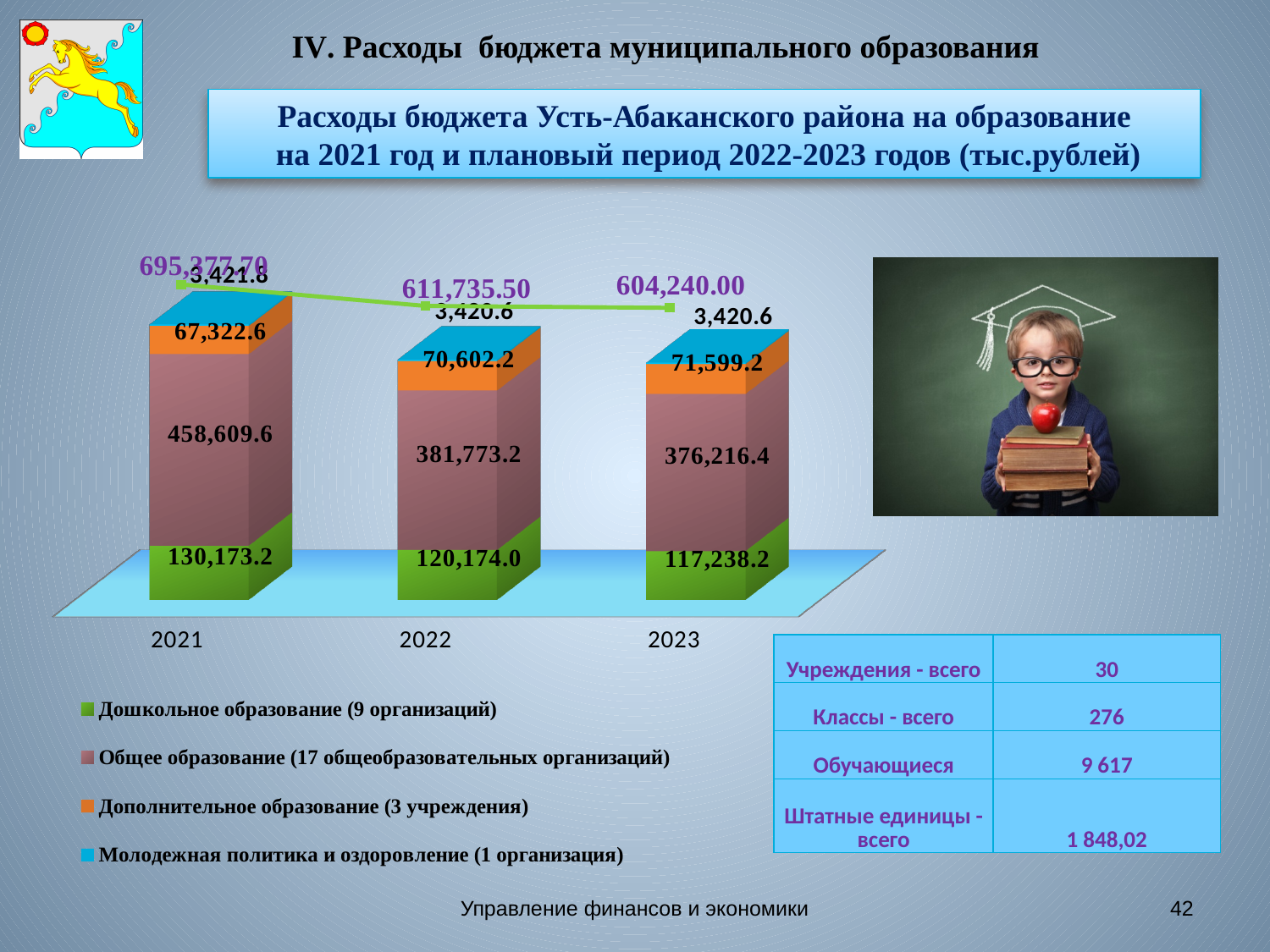
Does the value for Общее образование rise or fall from 2021 to 2023? Falls What kind of chart is shown on the slide? Stacked bar chart Which year has the larger value for Дополнительное образование, 2022 or 2023? 2023 What is the value for Общее образование in 2021? 458,609.6 What is the value for Дополнительное образование in 2022? 70,602.2 What value does the line label show for 2023? 604,240.00 How many series does the legend list? 4 In which year is the value for Дошкольное образование the lowest? 2023 What is the difference between the Дошкольное образование values for 2021 and 2022? 9,999.2 How many years are shown on the x axis of the chart? 3 In which year is the value for Общее образование the highest? 2021 What is the value for Дошкольное образование in 2023? 117,238.2